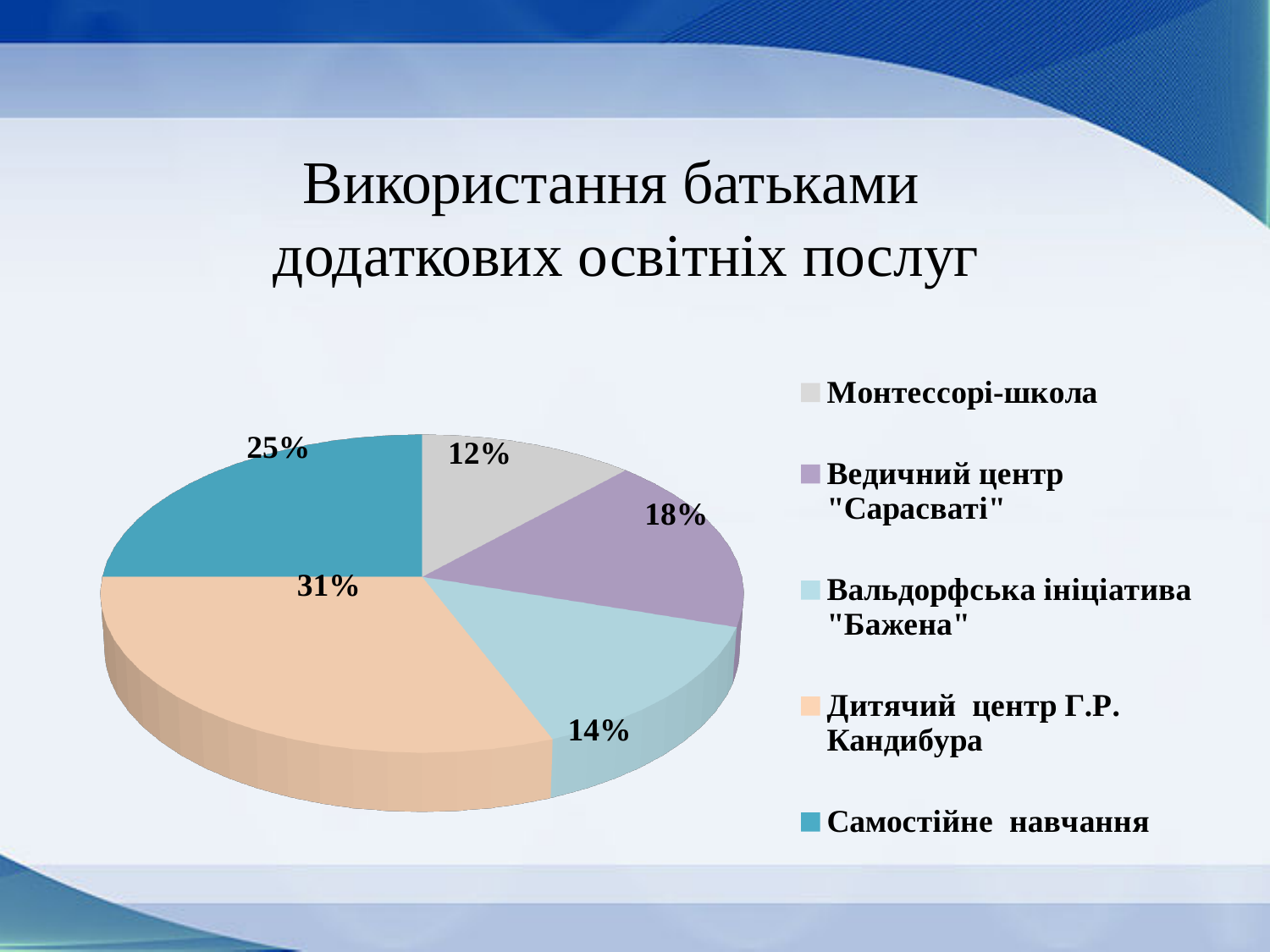
How many slices does the pie chart have? 5 Which category has the smallest share of the pie? Монтессорі-школа What share of the pie is Вальдорфська ініціатива "Бажена"? 14% What is the title of the chart? Використання батьками додаткових освітніх послуг What kind of chart is shown on the slide? pie chart What share of the pie is Ведичний центр "Сарасваті"? 18% Which category has the largest share of the pie? Дитячий центр Г.Р. Кандибура What share of the pie is Дитячий центр Г.Р. Кандибура? 31% Which is larger: the share for Ведичний центр "Сарасваті" or the share for Вальдорфська ініціатива "Бажена"? Ведичний центр "Сарасваті" What is the difference in percentage points between Дитячий центр Г.Р. Кандибура and Самостійне навчання? 6%